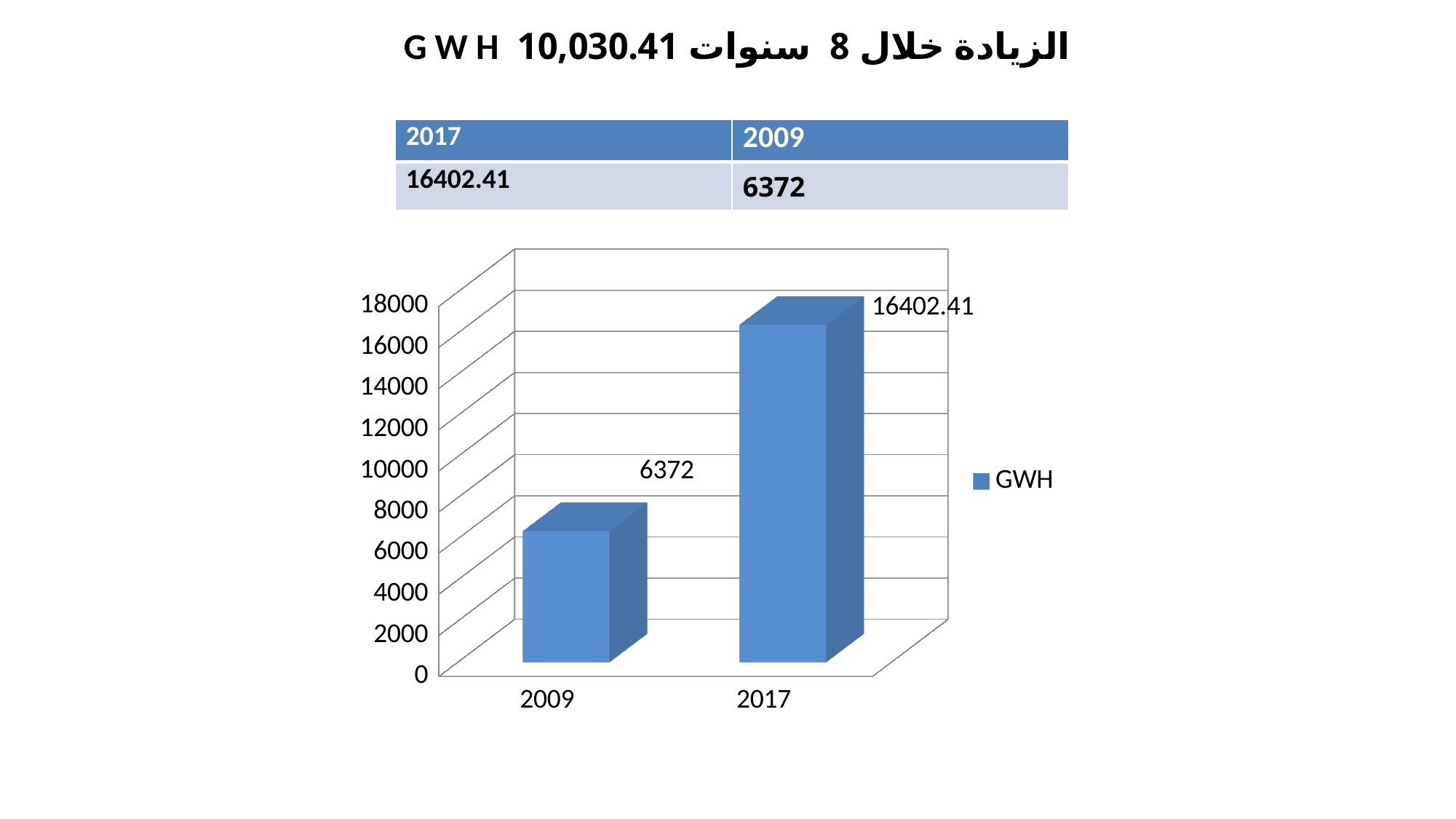
Which year has the lower GWH value? 2009 What is the difference between the GWH values for 2017 and 2009? 10030.41 What is the GWH value for 2017? 16402.41 Is the value for 2017 greater or less than 16000? greater Which year has the higher GWH value? 2017 What is the GWH value for 2009? 6372 How many years are shown on the x axis of the chart? 2 What is the name of the series in the chart legend? GWH Is the value for 2009 greater or less than 8000? less What kind of chart is shown on the slide? bar chart Is the GWH value for 2009 larger or smaller than the value for 2017? smaller How many series does the legend list? 1